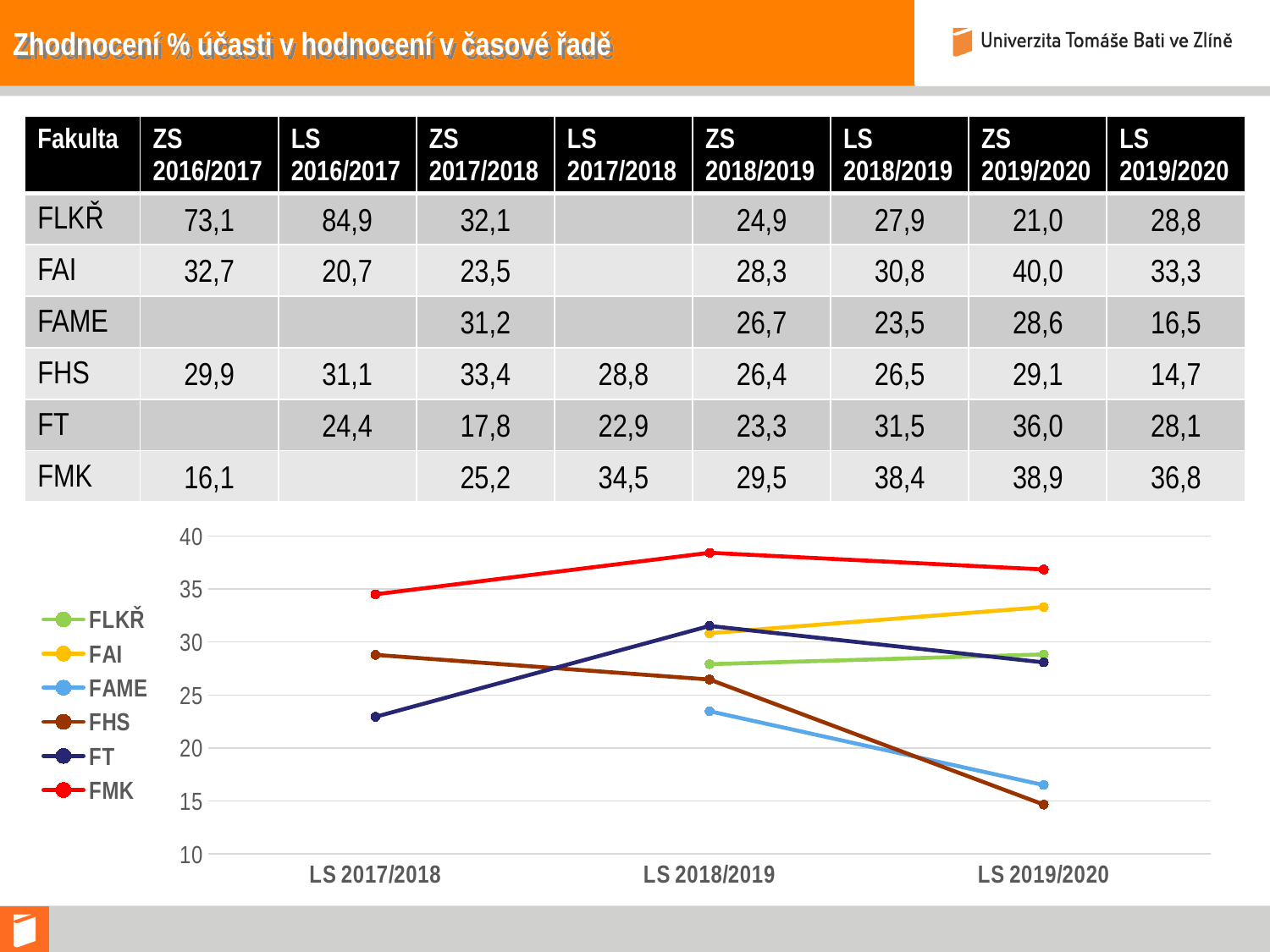
In the line chart, which faculty has the lowest value at LS 2019/2020? FHS In the line chart, does the FHS line rise or fall from LS 2017/2018 to LS 2019/2020? fall What kind of chart is shown at the bottom of the slide? line chart In the line chart, which is larger at LS 2017/2018, FHS or FT? FHS How many series does the legend of the line chart list? 6 In the line chart, is the value for FAME at LS 2019/2020 greater or less than 20? less What is the value for FMK at LS 2018/2019, as given in the table? 38,4 In the line chart, does the FAI line rise or fall from LS 2018/2019 to LS 2019/2020? rise In the line chart, is the value for FMK at LS 2018/2019 greater or less than 35? greater How many points are on the x axis of the line chart? 3 In the line chart, which faculty has the highest value at LS 2019/2020? FMK Which series in the line chart is drawn in red? FMK